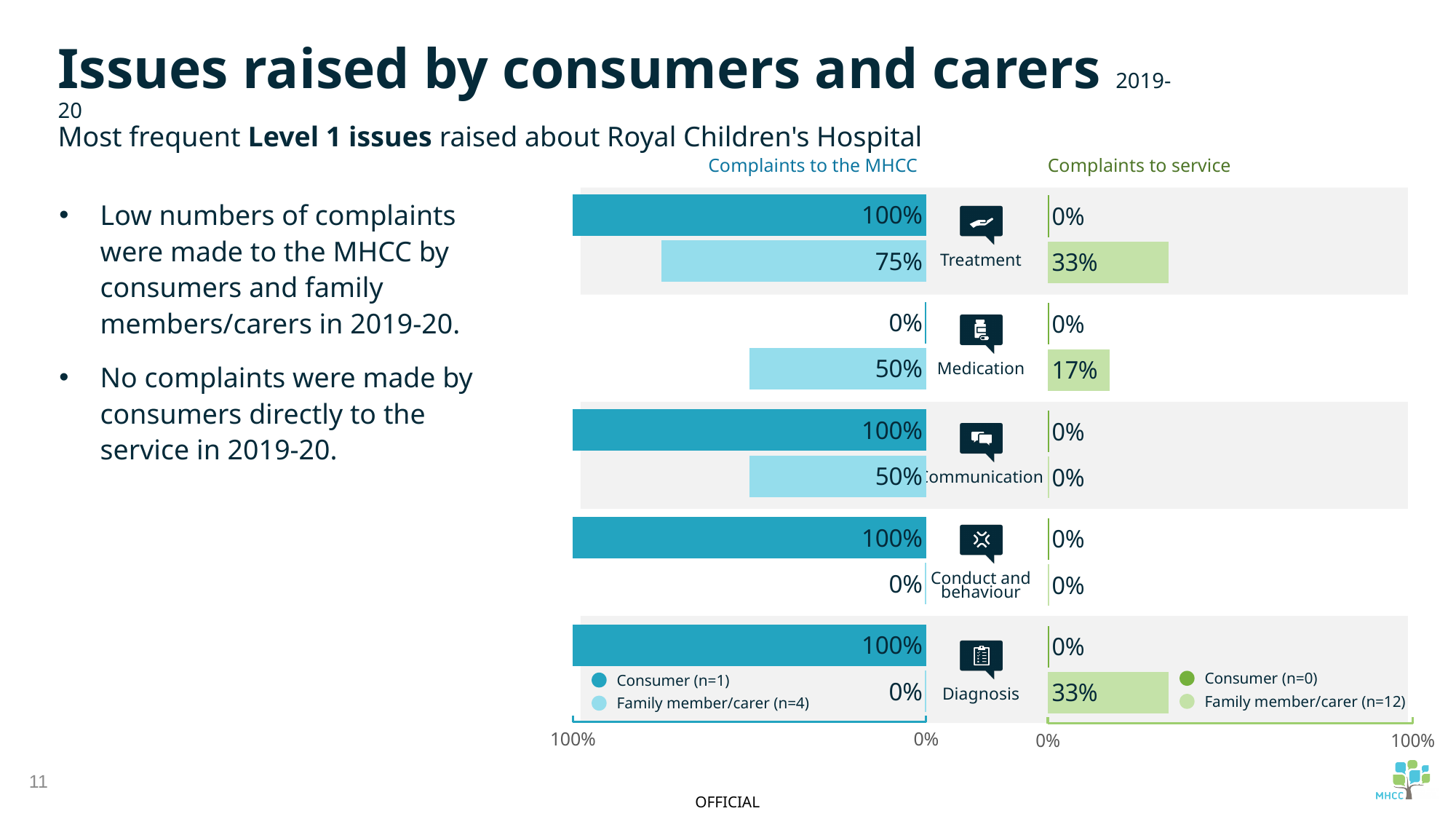
In the 'Complaints to the MHCC' chart, which category has the lowest Family member/carer value? Conduct and behaviour and Diagnosis (both 0%) In the 'Complaints to the MHCC' chart, what is the difference between the Consumer and Family member/carer values for Treatment? 25% In the 'Complaints to service' chart, is the Family member/carer value for Treatment larger or smaller than the Family member/carer value for Medication? larger How many series does the legend of the 'Complaints to the MHCC' chart list? 2 How many issue categories are shown in the charts? 5 In the 'Complaints to service' chart, which categories have the highest Family member/carer value? Treatment and Diagnosis (both 33%) In the 'Complaints to the MHCC' chart, what is the Consumer value for Medication? 0% What type of chart is used for 'Complaints to the MHCC'? Bar chart In the 'Complaints to the MHCC' chart, what is the Family member/carer value for Treatment? 75% In the 'Complaints to service' chart, what is the Family member/carer value for Medication? 17% In the 'Complaints to service' chart, what is the Family member/carer value for Diagnosis? 33% According to the legend of the 'Complaints to service' chart, what is the sample size (n) for Family member/carer? n=12